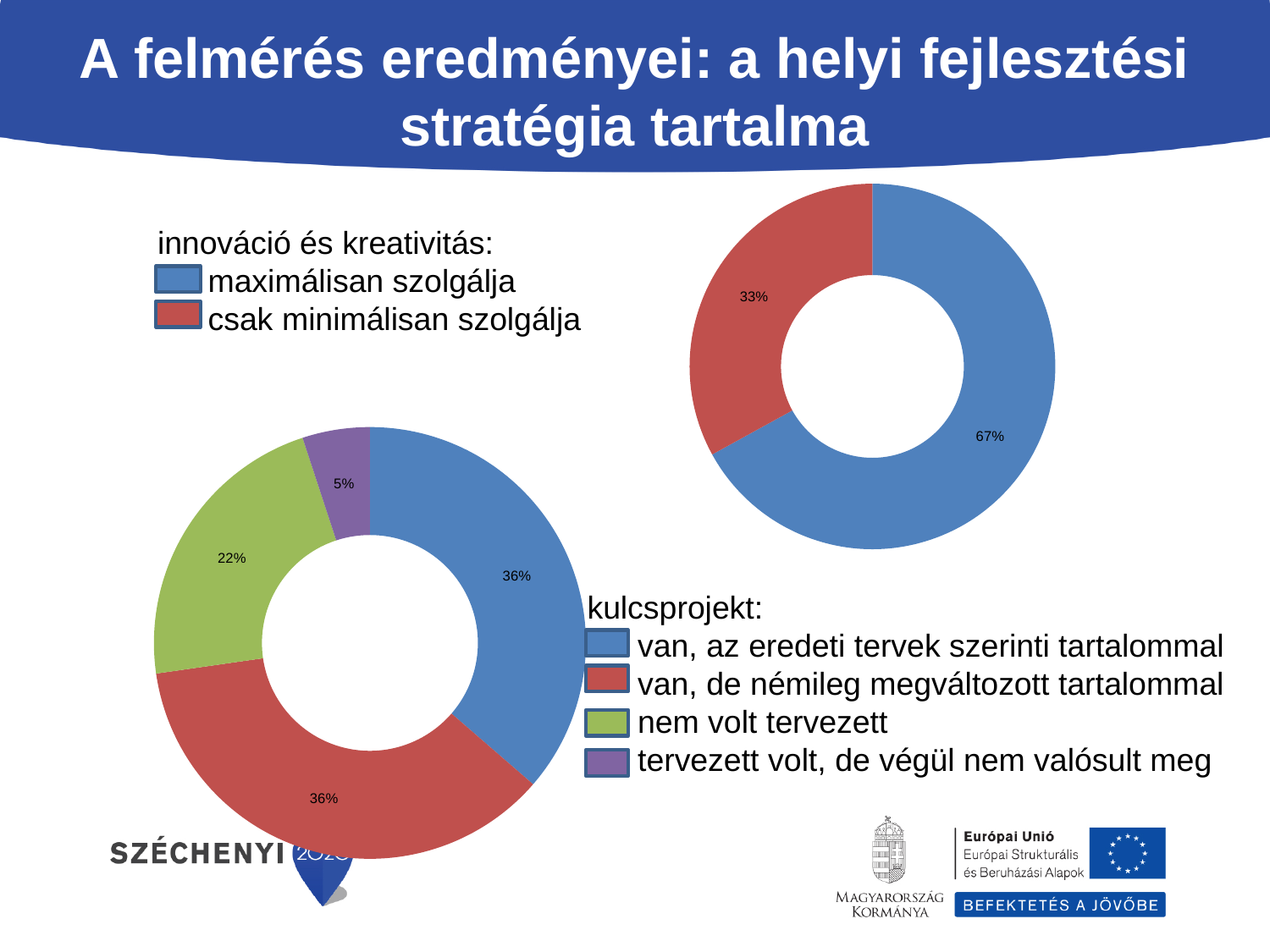
In the 'innováció és kreativitás' chart (top right), what share is labelled for 'csak minimálisan szolgálja'? 33% In the 'kulcsprojekt' chart (bottom left), which is larger: the share for 'nem volt tervezett' or the share for 'tervezett volt, de végül nem valósult meg'? nem volt tervezett In the 'innováció és kreativitás' chart (top right), what is the difference between the two shares? 34% In the 'kulcsprojekt' chart (bottom left), what share is labelled for 'van, az eredeti tervek szerinti tartalommal'? 36% In the 'kulcsprojekt' chart (bottom left), what share is labelled for 'tervezett volt, de végül nem valósult meg'? 5% In the 'kulcsprojekt' chart (bottom left), what share is labelled for 'nem volt tervezett'? 22% In the 'kulcsprojekt' chart (bottom left), how many categories does the legend list? 4 What type of chart is used for the 'innováció és kreativitás' data (top right)? Doughnut (pie) chart In the 'innováció és kreativitás' chart (top right), which category has the larger share? maximálisan szolgálja In the 'innováció és kreativitás' chart (top right), what share is labelled for 'maximálisan szolgálja'? 67% In the 'kulcsprojekt' chart (bottom left), what is the difference between the shares for 'nem volt tervezett' and 'tervezett volt, de végül nem valósult meg'? 17% In the 'kulcsprojekt' chart (bottom left), which category has the smallest share? tervezett volt, de végül nem valósult meg